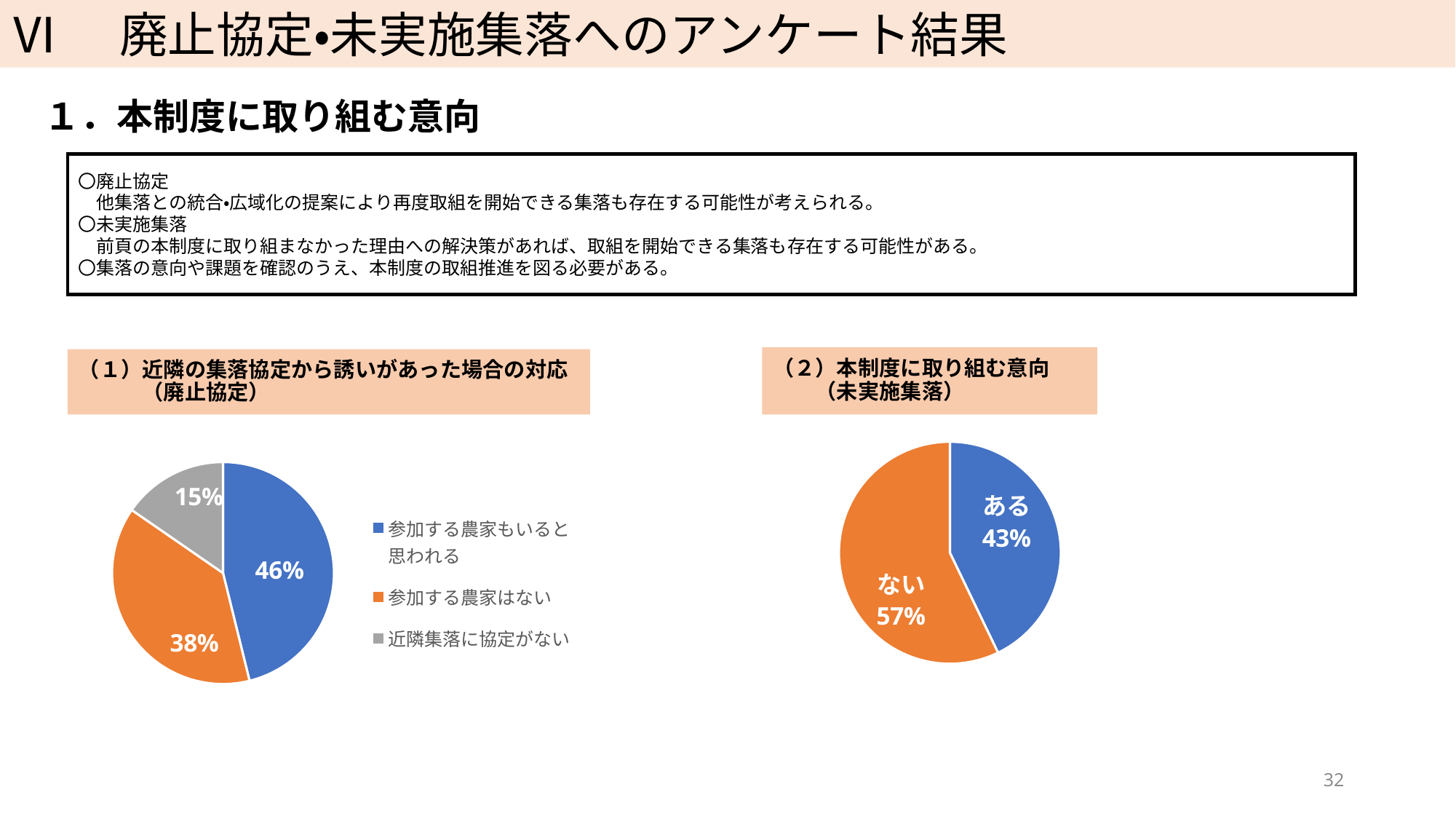
In the left pie chart (近隣の集落協定から誘いがあった場合の対応), how many categories does the legend list? 3 In the right pie chart (本制度に取り組む意向), what is the difference in percentage points between ない and ある? 14 percentage points In the left pie chart (近隣の集落協定から誘いがあった場合の対応), what share is labelled for 参加する農家もいると思われる? 46% What type of chart is used for both charts on the slide? Pie chart In the right pie chart (本制度に取り組む意向), what share is labelled for ない? 57% In the left pie chart (近隣の集落協定から誘いがあった場合の対応), what share is labelled for 近隣集落に協定がない? 15% In the right pie chart (本制度に取り組む意向), what share is labelled for ある? 43% In the left pie chart (近隣の集落協定から誘いがあった場合の対応), what is the difference in percentage points between 参加する農家もいると思われる and 参加する農家はない? 8 percentage points In the left pie chart (近隣の集落協定から誘いがあった場合の対応), which category has the smallest share? 近隣集落に協定がない In the right pie chart (本制度に取り組む意向), which is larger, ある or ない? ない In the left pie chart (近隣の集落協定から誘いがあった場合の対応), which category has the largest share? 参加する農家もいると思われる In the left pie chart (近隣の集落協定から誘いがあった場合の対応), what share is labelled for 参加する農家はない? 38%